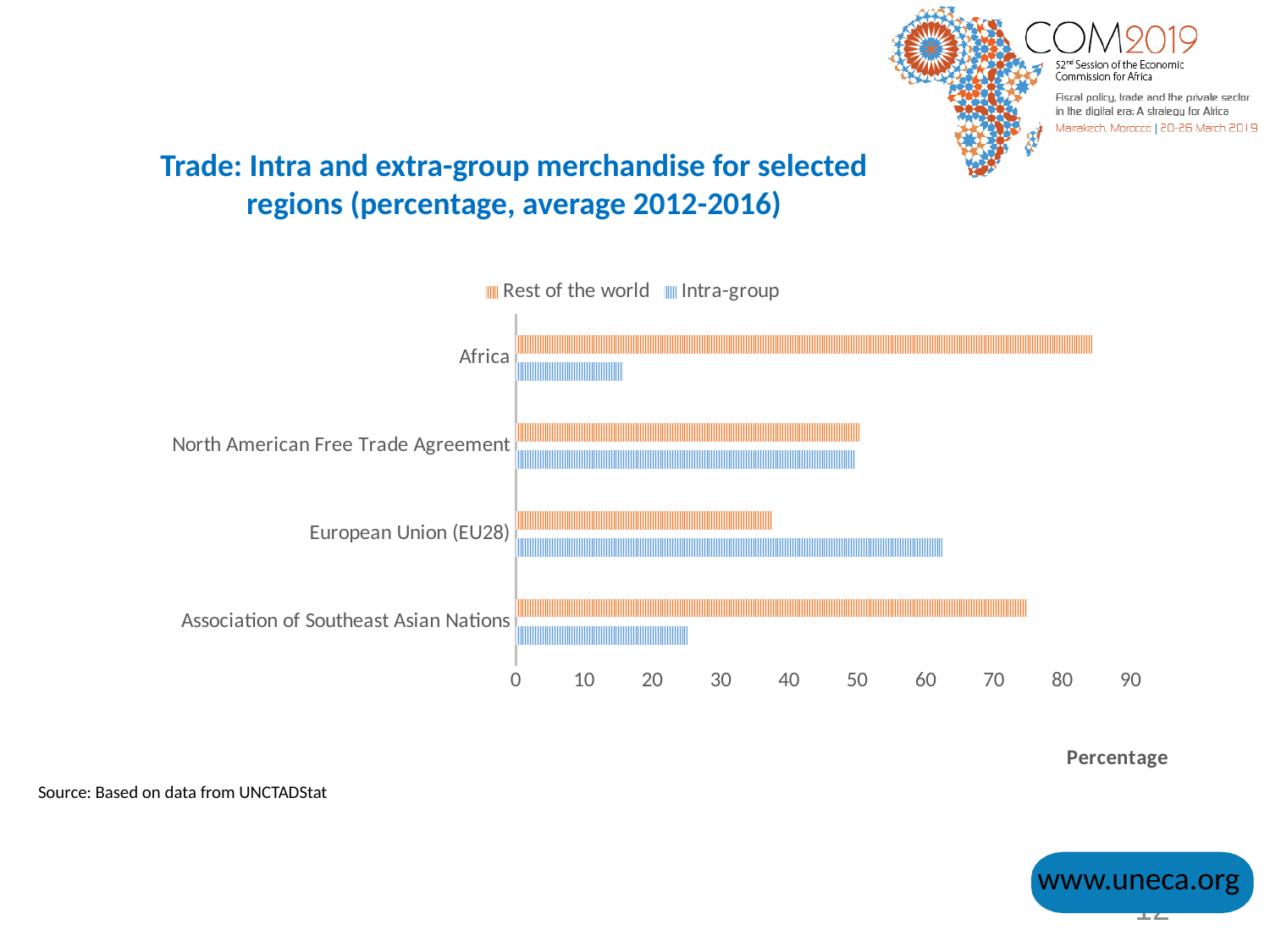
How many series does the chart legend list? 2 Which region has the highest value for Rest of the world? Africa What kind of chart is shown on the slide? bar chart Is the Rest of the world value for Africa greater or less than 80? greater Is the Intra-group value for Africa greater or less than 20? less Is the Rest of the world value for Association of Southeast Asian Nations greater or less than 70? greater Which region has the lowest value for Intra-group? Africa Which two series are listed in the chart legend? Rest of the world and Intra-group How many regions (categories) are plotted on the chart? 4 What is the label on the horizontal axis of the chart? Percentage Which region has the highest value for Intra-group? European Union (EU28) For European Union (EU28), which is larger: Rest of the world or Intra-group? Intra-group